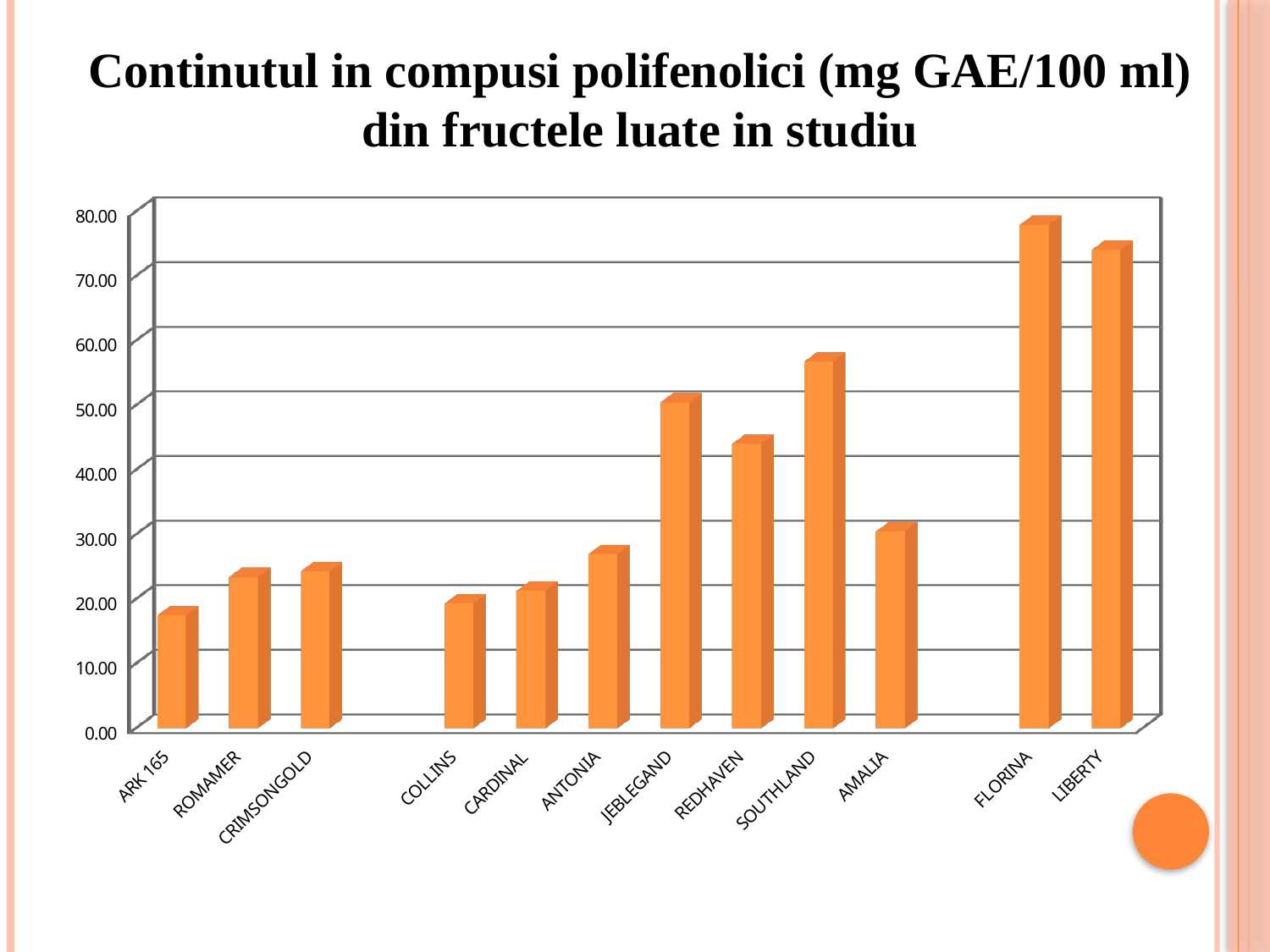
Which has a higher value, SOUTHLAND or REDHAVEN? SOUTHLAND What unit is given in the chart title for the polyphenol content? mg GAE/100 ml Is the value for AMALIA greater or less than 40.00? less Which variety has the highest polyphenol content? FLORINA Which variety has the lowest polyphenol content? ARK 165 Which has a higher value, JEBLEGAND or AMALIA? JEBLEGAND What kind of chart is shown on the slide? bar chart Is the value for SOUTHLAND greater or less than 50.00? greater Is the value for FLORINA greater or less than 70.00? greater How many fruit varieties (bars) are plotted in the chart? 12